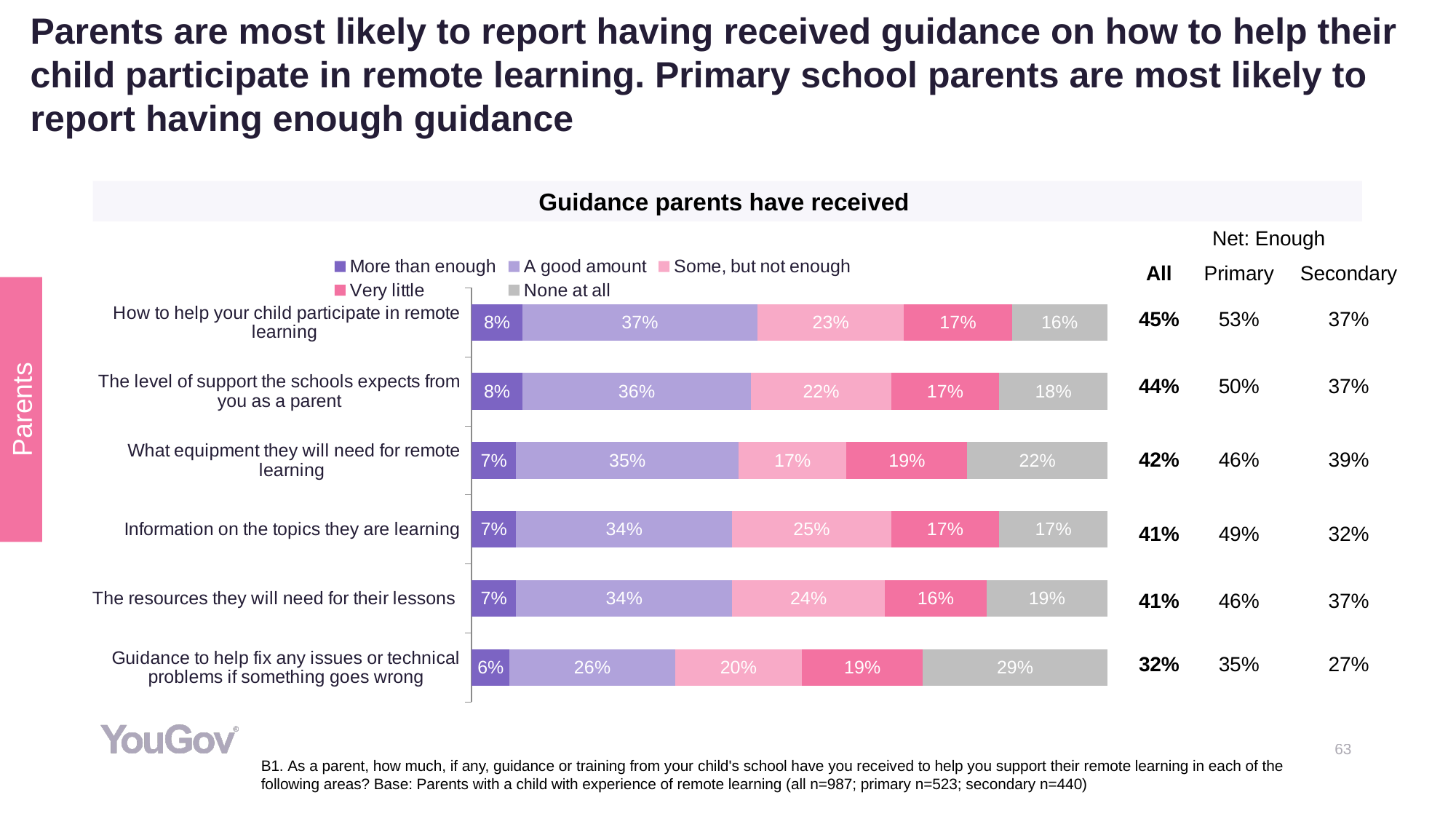
Which category has the lowest 'More than enough' value? Guidance to help fix any issues or technical problems if something goes wrong Which has the larger 'Very little' value: 'What equipment they will need for remote learning' or 'How to help your child participate in remote learning'? What equipment they will need for remote learning What is the 'A good amount' value for 'How to help your child participate in remote learning'? 37% What is the 'Very little' value for 'The resources they will need for their lessons'? 16% What is the difference between the 'Some, but not enough' values for 'Information on the topics they are learning' and 'What equipment they will need for remote learning'? 8 percentage points How many categories (guidance areas) are plotted in the chart? 6 How many series does the chart legend list? 5 Which category has the highest 'None at all' value? Guidance to help fix any issues or technical problems if something goes wrong What is the title of the chart? Guidance parents have received What kind of chart is shown on the slide? Stacked bar chart What is the total of the stacked bar for 'What equipment they will need for remote learning'? 100% What is the 'None at all' value for 'Guidance to help fix any issues or technical problems if something goes wrong'? 29%